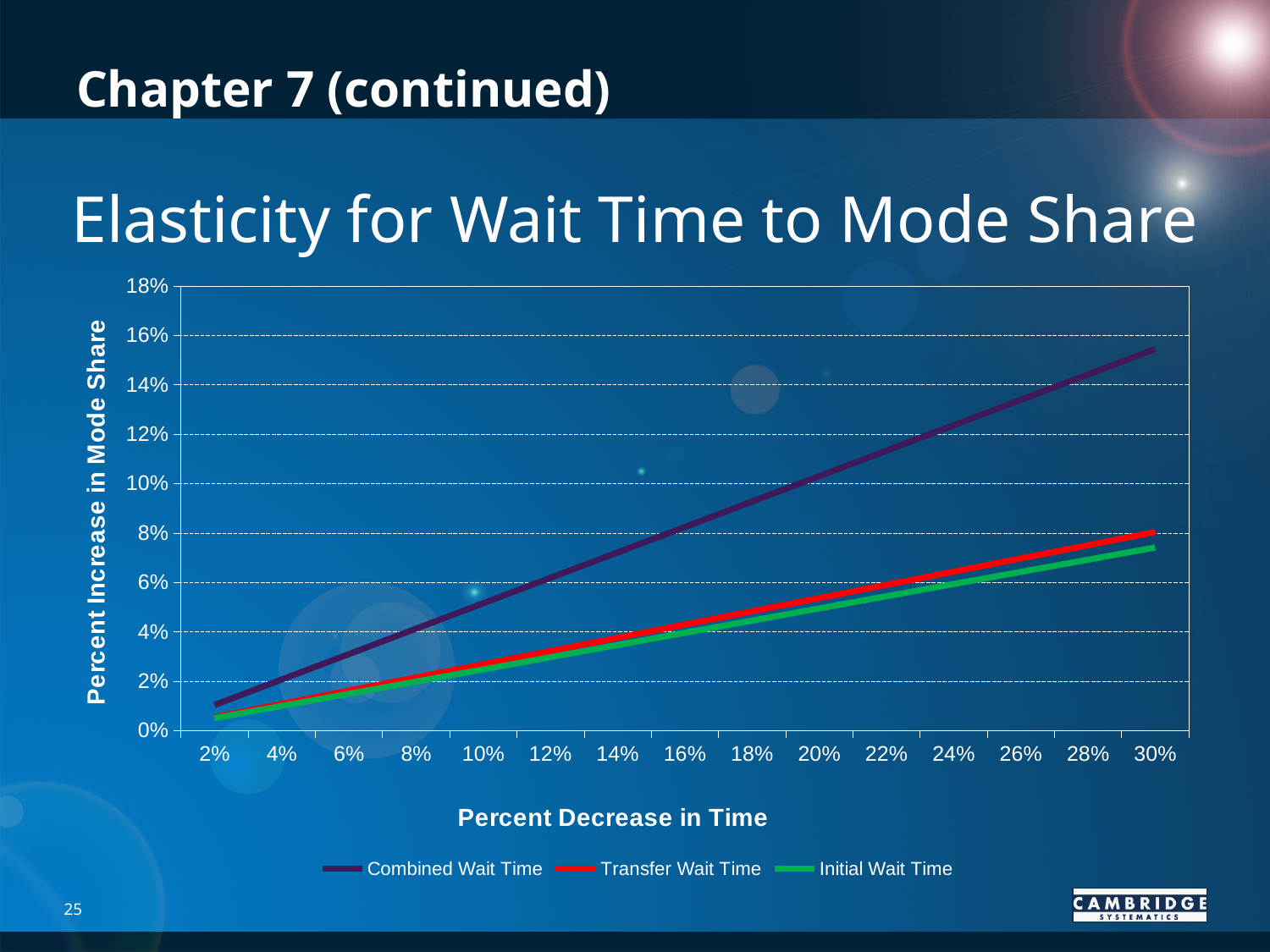
How many series does the legend list? 3 What is the label of the y axis? Percent Increase in Mode Share At a 30% decrease in time, which is larger: Combined Wait Time or Initial Wait Time? Combined Wait Time Which series has the highest value at a 30% decrease in time? Combined Wait Time What is the title of the chart? Elasticity for Wait Time to Mode Share What kind of chart is shown on the slide? Line chart Is the value for Combined Wait Time at 2% greater or less than 2%? less Is the value for Combined Wait Time at 16% greater or less than 6%? greater Do the values for Combined Wait Time rise or fall as the percent decrease in time increases? Rise Is the value for Combined Wait Time at 30% greater or less than 14%? greater How many percent-decrease-in-time values are marked along the x axis? 15